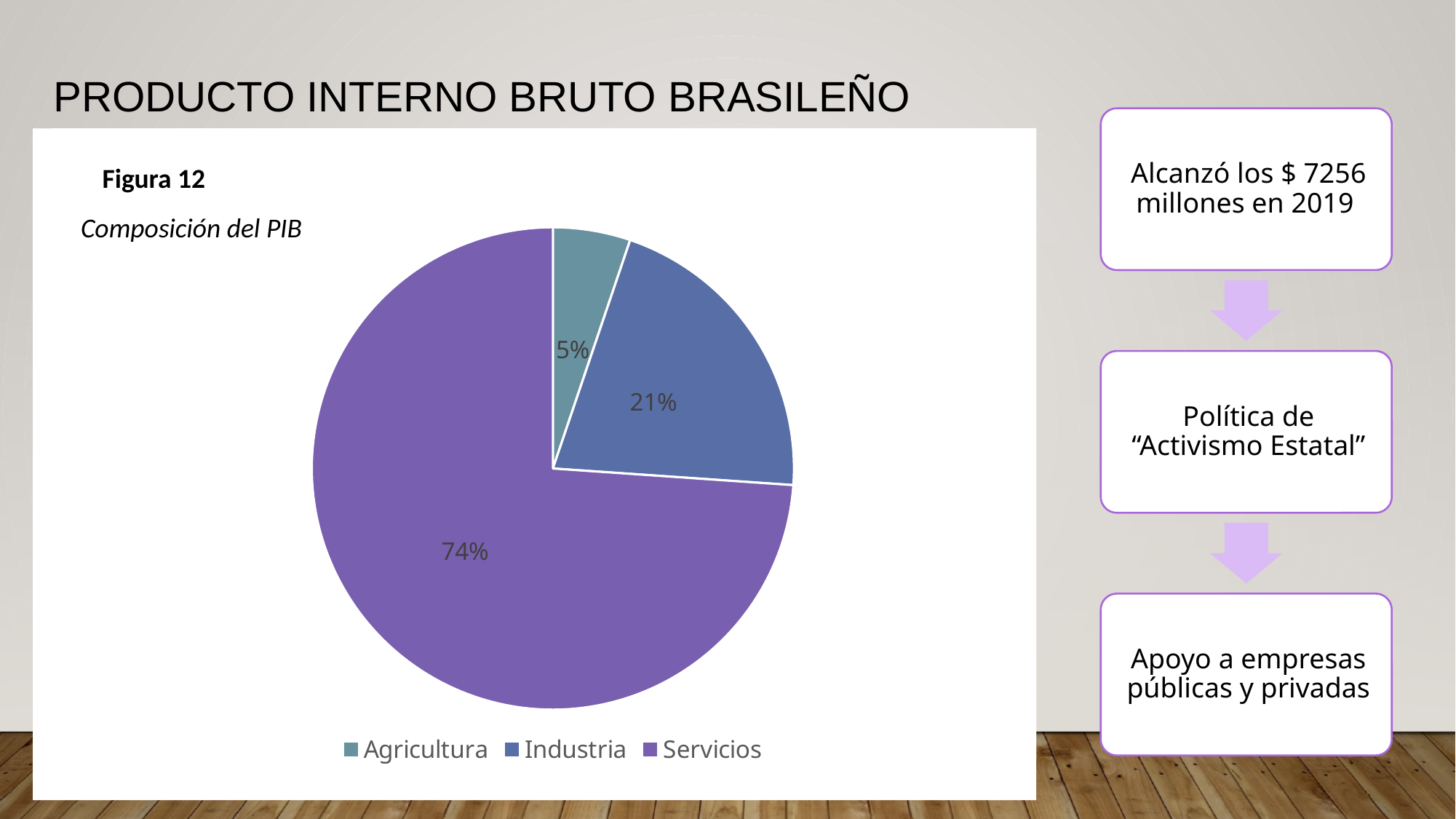
What is the difference in percentage points between Servicios and Industria? 53 Which category has the smallest slice of the pie? Agricultura How many categories does the pie chart have? 3 Which colour represents Servicios in the legend? purple What is the subtitle of the chart shown below 'Figura 12'? Composición del PIB What share of the pie does Industria represent? 21% What is the difference in percentage points between Industria and Agricultura? 16 What share of the pie does Agricultura represent? 5% Which is larger, the share for Industria or the share for Agricultura? Industria What kind of chart is shown on the slide? pie chart What share of the pie does Servicios represent? 74% Which category has the largest slice of the pie? Servicios